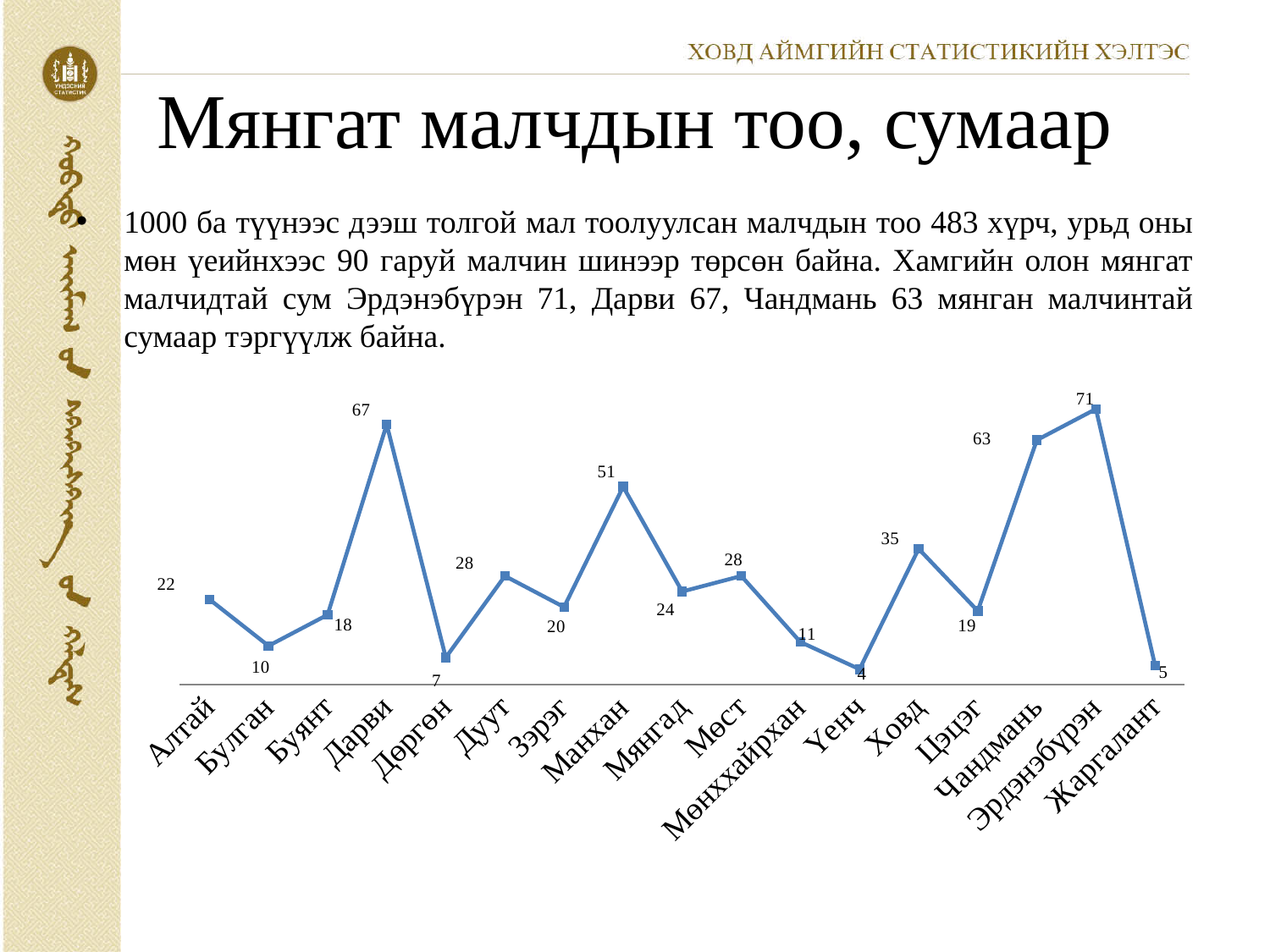
What is the value for Ховд? 35 Which category has the lowest value? Үенч How many categories are plotted on the x axis? 17 Which is larger, the value for Алтай or the value for Мянгад? Мянгад What is the difference between the values for Дарви and Дөргөн? 60 What is the difference between the values for Эрдэнэбүрэн and Чандмань? 8 What is the value for Манхан? 51 What is the value for Дарви? 67 Which category has the highest value? Эрдэнэбүрэн Do the values rise or fall from Цэцэг to Эрдэнэбүрэн? rise What is the value for Дөргөн? 7 What kind of chart is shown on the slide? line chart